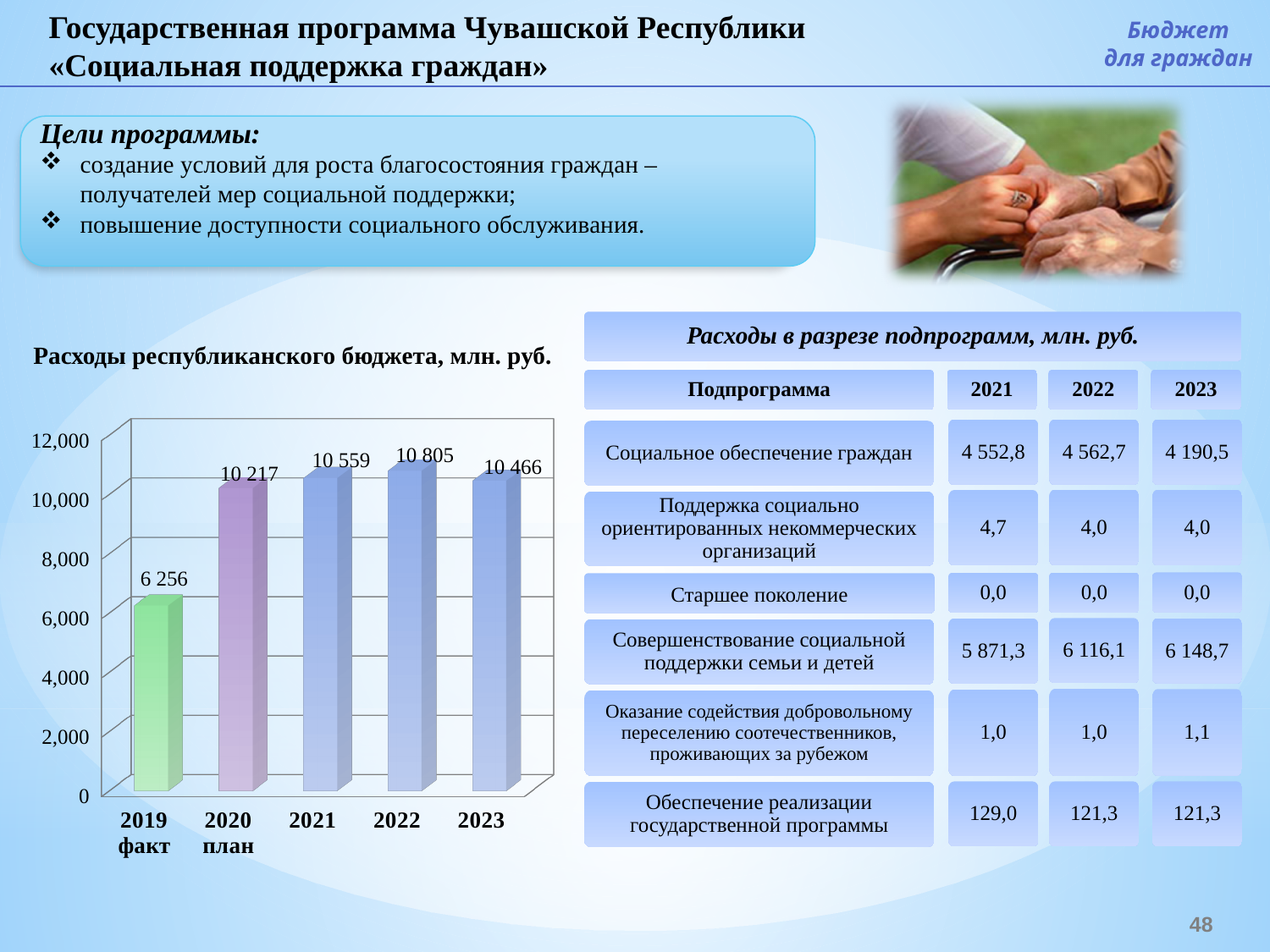
In the chart 'Расходы республиканского бюджета, млн. руб.', which is larger: the value for 2021 or the value for 2023? 2021 Which category has the lowest value in the chart 'Расходы республиканского бюджета, млн. руб.'? 2019 факт What is the title of the chart on the left side of the slide? Расходы республиканского бюджета, млн. руб. What kind of chart is 'Расходы республиканского бюджета, млн. руб.'? bar chart In the chart 'Расходы республиканского бюджета, млн. руб.', what is the difference between the values for 2022 and 2019 факт? 4 549 Which year has the highest value in the chart 'Расходы республиканского бюджета, млн. руб.'? 2022 What is the value for 2020 план in the chart 'Расходы республиканского бюджета, млн. руб.'? 10 217 How many bars are shown in the chart 'Расходы республиканского бюджета, млн. руб.'? 5 In the chart 'Расходы республиканского бюджета, млн. руб.', what is the difference between the values for 2022 and 2023? 339 What is the value for 2022 in the chart 'Расходы республиканского бюджета, млн. руб.'? 10 805 In the chart 'Расходы республиканского бюджета, млн. руб.', is the value for 2019 факт greater or less than 8,000? less What is the value for 2019 факт in the chart 'Расходы республиканского бюджета, млн. руб.'? 6 256